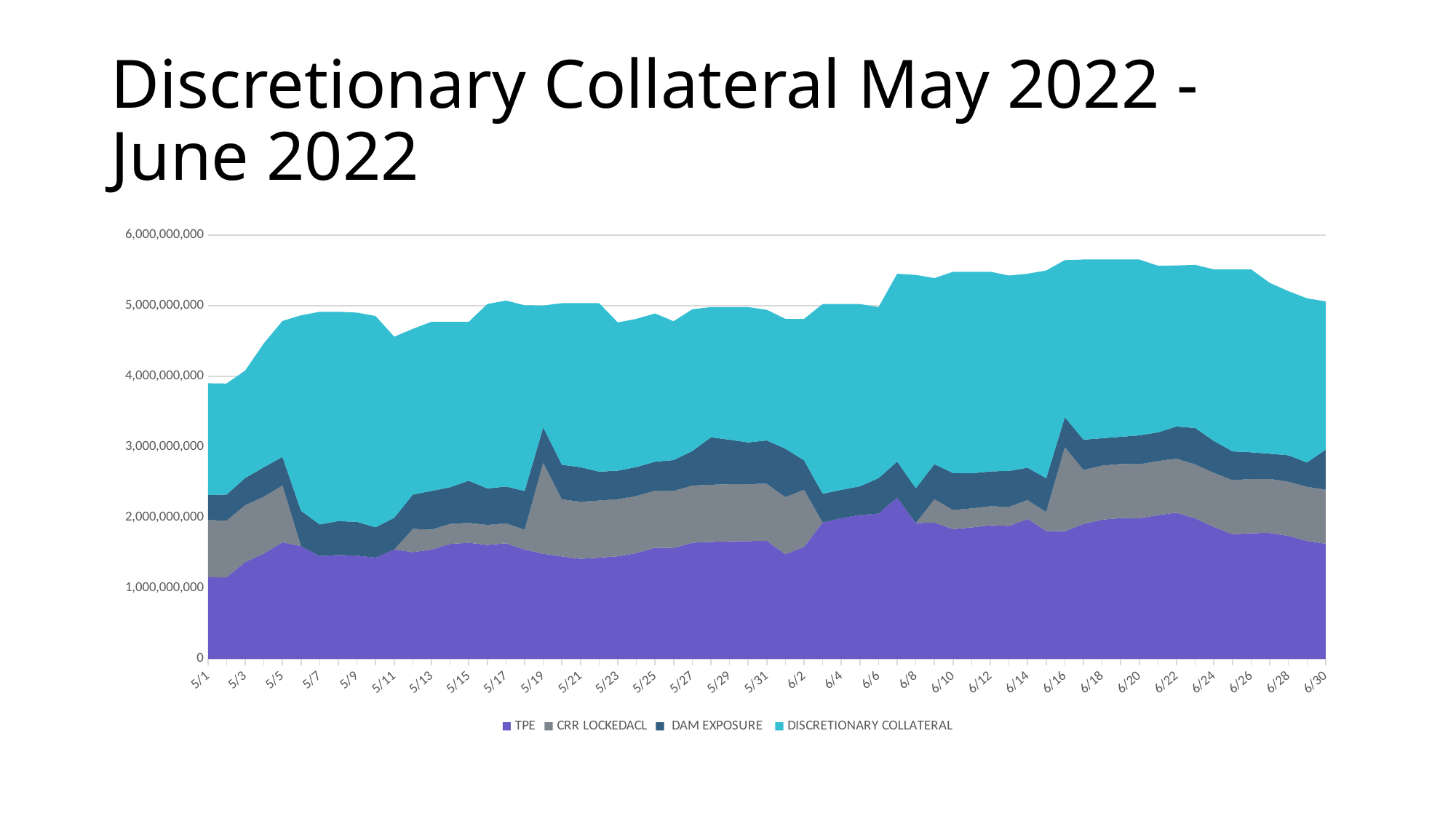
What is the title of the chart on the slide? Discretionary Collateral May 2022 - June 2022 Is the total stacked value on 5/17 greater or less than 6,000,000,000? less Does the total stacked value generally rise or fall from 5/1 to 6/18? rise Is the TPE value on 5/1 greater or less than 1,000,000,000? greater Is the total stacked value on 6/18 greater or less than 5,000,000,000? greater How many series does the legend list? 4 Which series is plotted at the bottom of the stack? TPE Which is larger, the total stacked value on 6/18 or on 5/1? 6/18 What kind of chart is shown on the slide? Stacked area chart What is the last date label shown on the x axis? 6/30